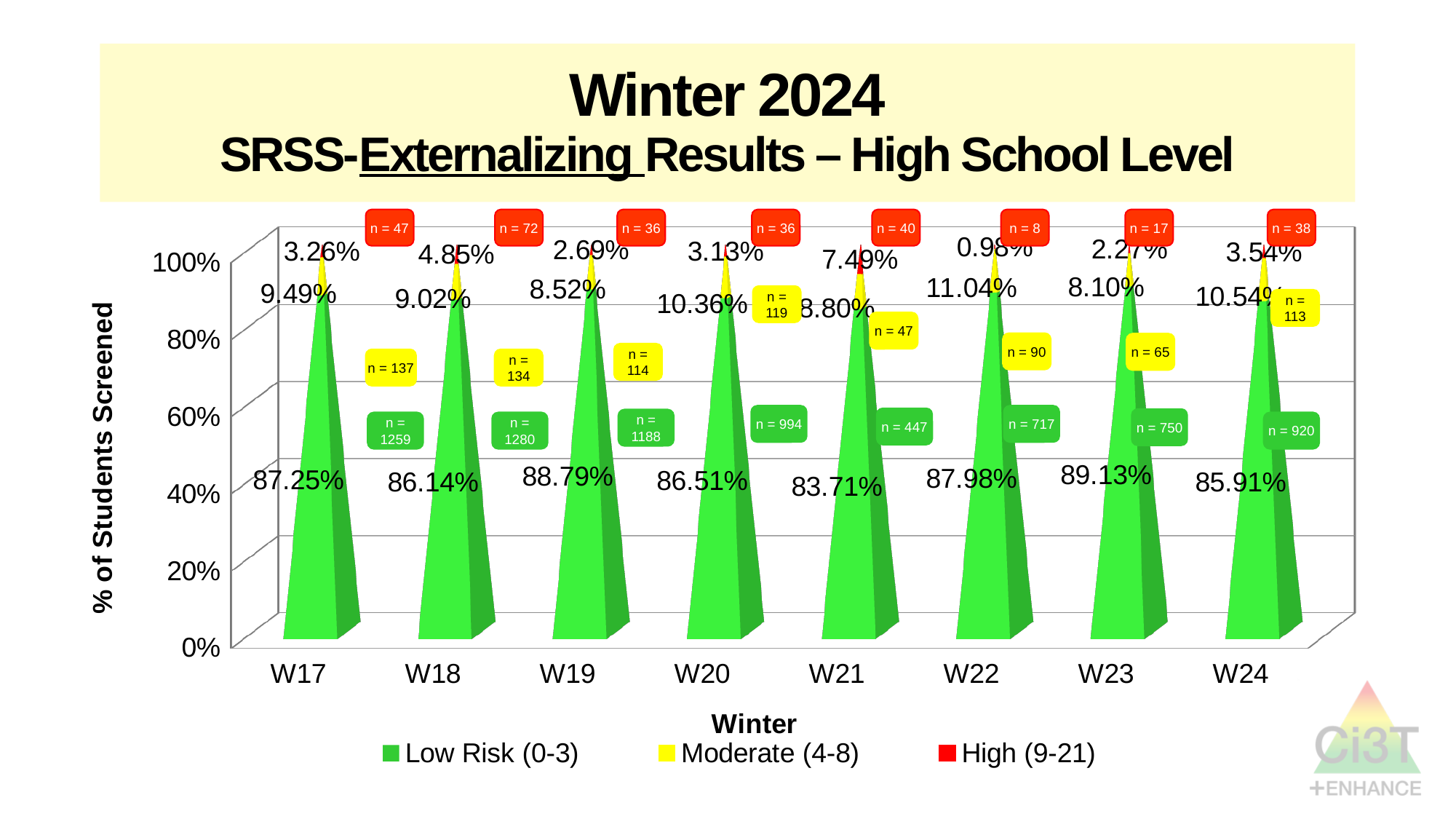
What is the Low Risk (0-3) percentage for W21? 83.71% Which is larger, the Moderate (4-8) percentage for W20 or for W19? W20 How many winters are shown on the x axis? 8 How many series does the legend list? 3 What is the difference between the Low Risk (0-3) percentages for W23 and W21? 5.42% Which winter has the highest High (9-21) percentage? W21 Which winter has the lowest High (9-21) percentage? W22 Which winter has the highest Low Risk (0-3) percentage? W23 What is the High (9-21) percentage for W18? 4.85% What is the n value shown for the High (9-21) group in W22? n = 8 What is the Moderate (4-8) percentage for W22? 11.04% What kind of chart is shown on the slide? Stacked bar chart